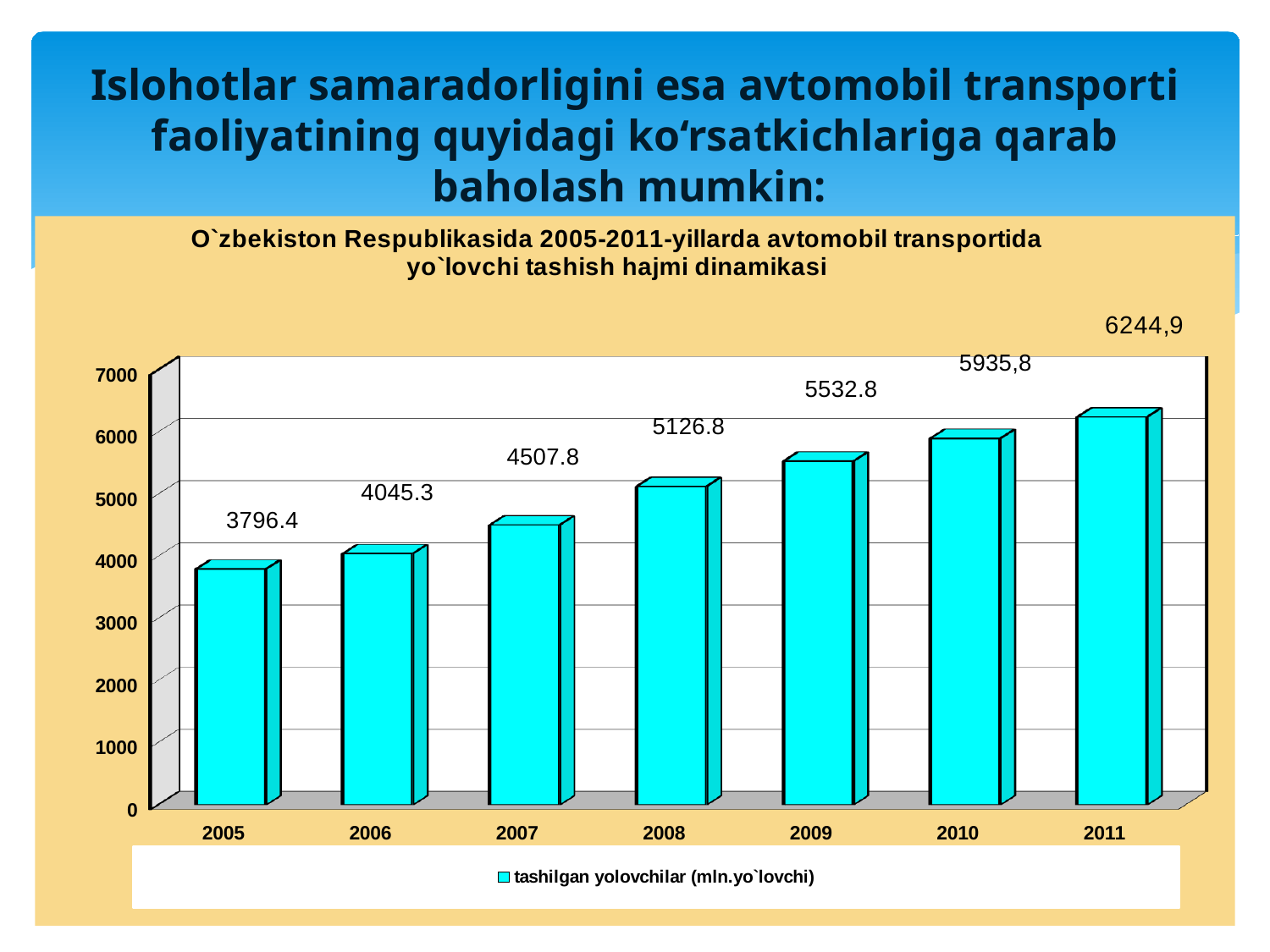
What is the value for 2005? 3796.4 Do the values rise or fall from 2005 to 2011? rise What is the difference between the values for 2009 and 2008? 406.0 How many years are shown on the x axis? 7 What is the value for 2011? 6244,9 What is the difference between the values for 2008 and 2007? 619.0 Which year has the highest value? 2011 Which is larger, the value for 2006 or the value for 2009? 2009 Is the value for 2010 greater or less than 5000? greater What is the value for 2008? 5126.8 Which year has the lowest value? 2005 What kind of chart is shown? bar chart